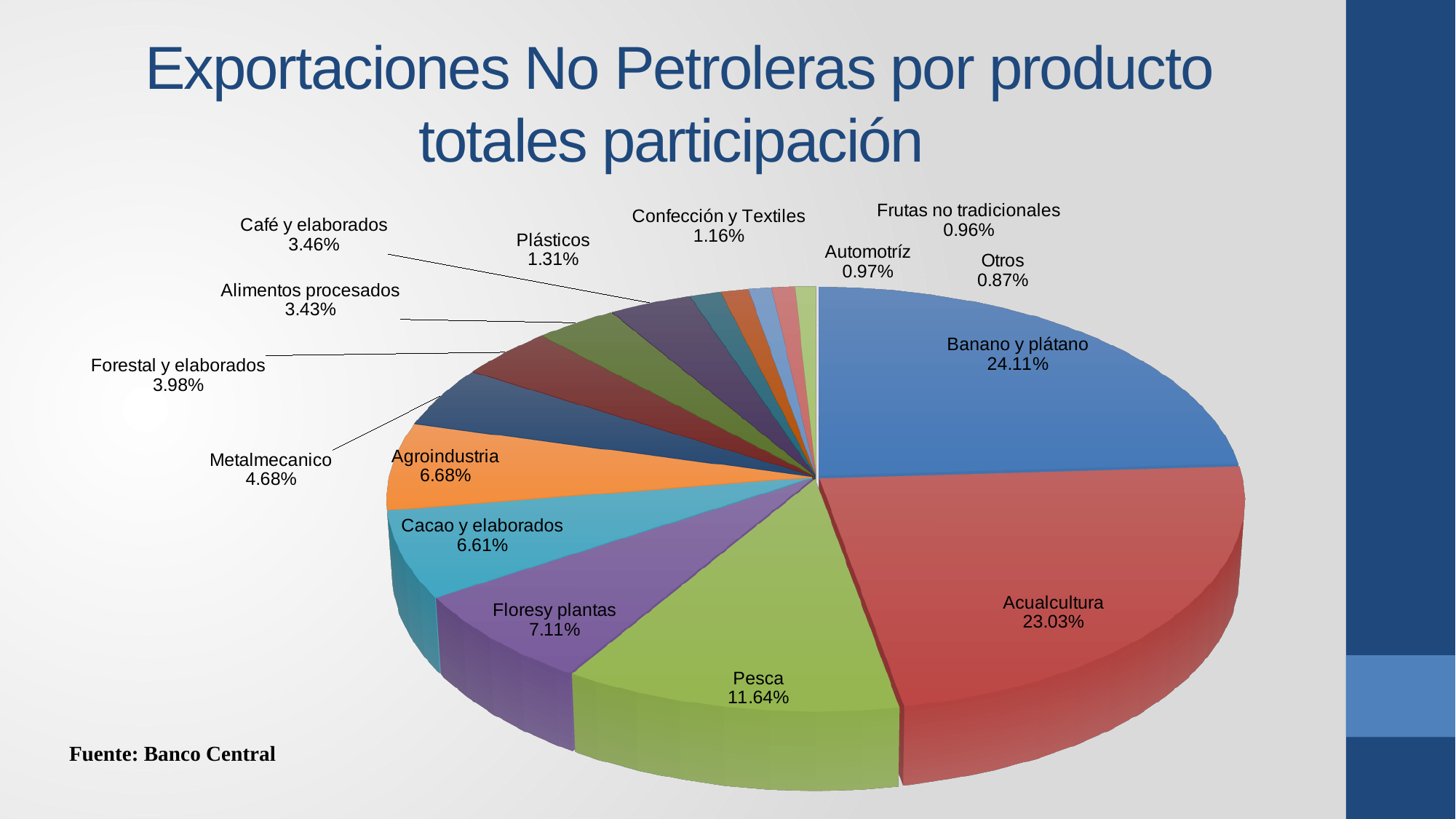
What is the difference between the shares of Pesca and Floresy plantas? 4.53% Which product has the largest share of the pie? Banano y plátano Which category has the smallest share of the pie? Otros Which is larger, the share of Acualcultura or the share of Pesca? Acualcultura What share of non-oil exports does Banano y plátano account for? 24.11% What is the value shown for Plásticos? 1.31% What is the difference between the shares of Banano y plátano and Acualcultura? 1.08% What kind of chart is shown on the slide? pie chart How many slices does the pie chart have? 15 What is the value shown for Pesca? 11.64% What source is cited for the chart? Banco Central What percentage is shown for Metalmecanico? 4.68%